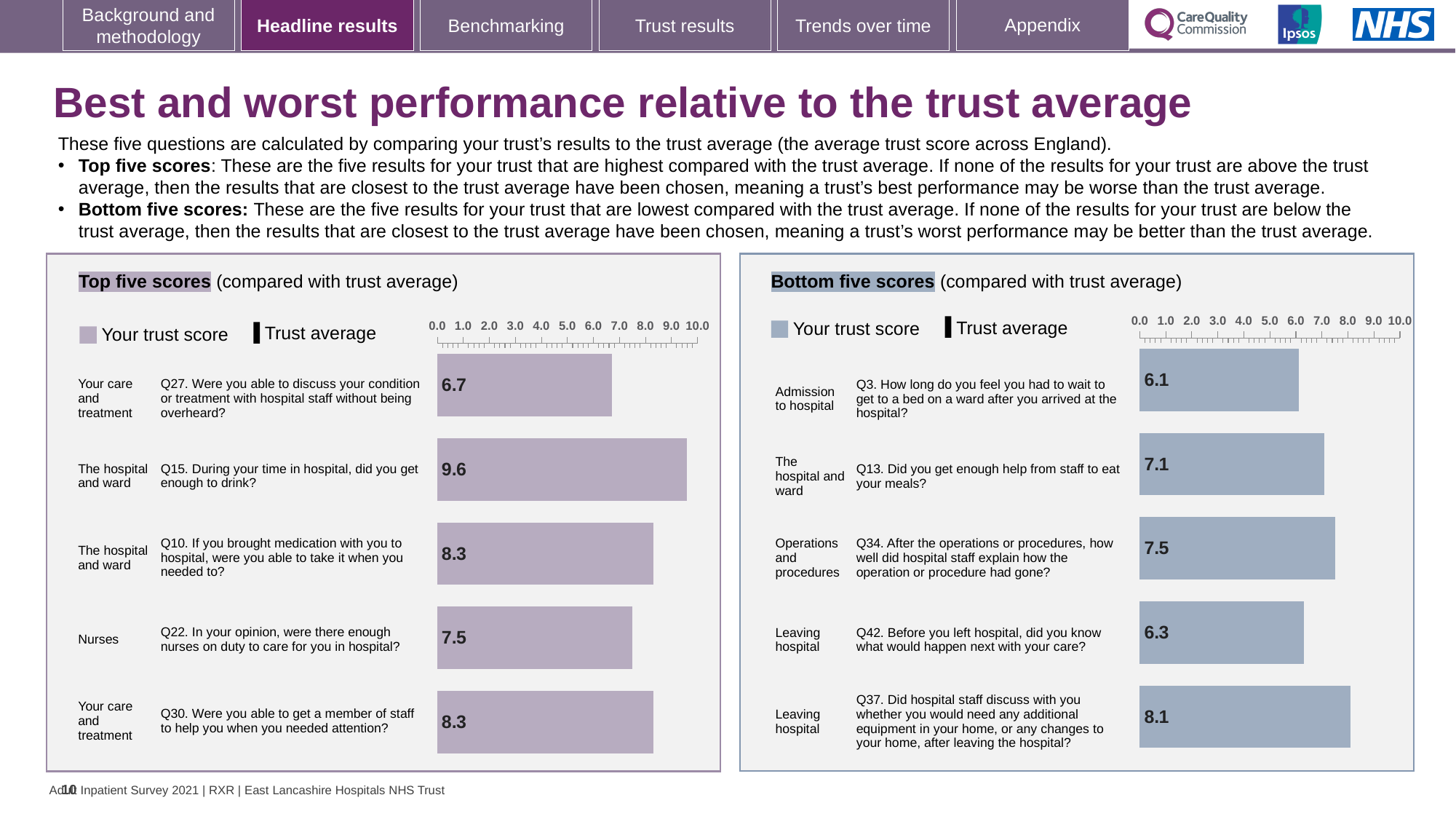
How many entries does the legend of the 'Top five scores' chart list? 2 In the 'Bottom five scores' chart, which question has the highest trust score? Q37 In the 'Top five scores' chart, which question has the lowest trust score? Q27 In the 'Top five scores' chart, what is the trust score for Q27 (discuss your condition without being overheard)? 6.7 In the 'Top five scores' chart, which question has the highest trust score? Q15 How many questions are shown in the 'Bottom five scores' chart? 5 In the 'Bottom five scores' chart, what is the trust score for Q13 (enough help from staff to eat your meals)? 7.1 In the 'Bottom five scores' chart, is the trust score for Q34 larger or smaller than the trust score for Q42? larger In the 'Top five scores' chart, what is the trust score for Q15 (did you get enough to drink)? 9.6 In the 'Bottom five scores' chart, which question has the lowest trust score? Q3 In the 'Bottom five scores' chart, what is the trust score for Q37 (discuss additional equipment or changes to your home)? 8.1 In the 'Top five scores' chart, what is the difference between the trust scores for Q15 and Q22? 2.1